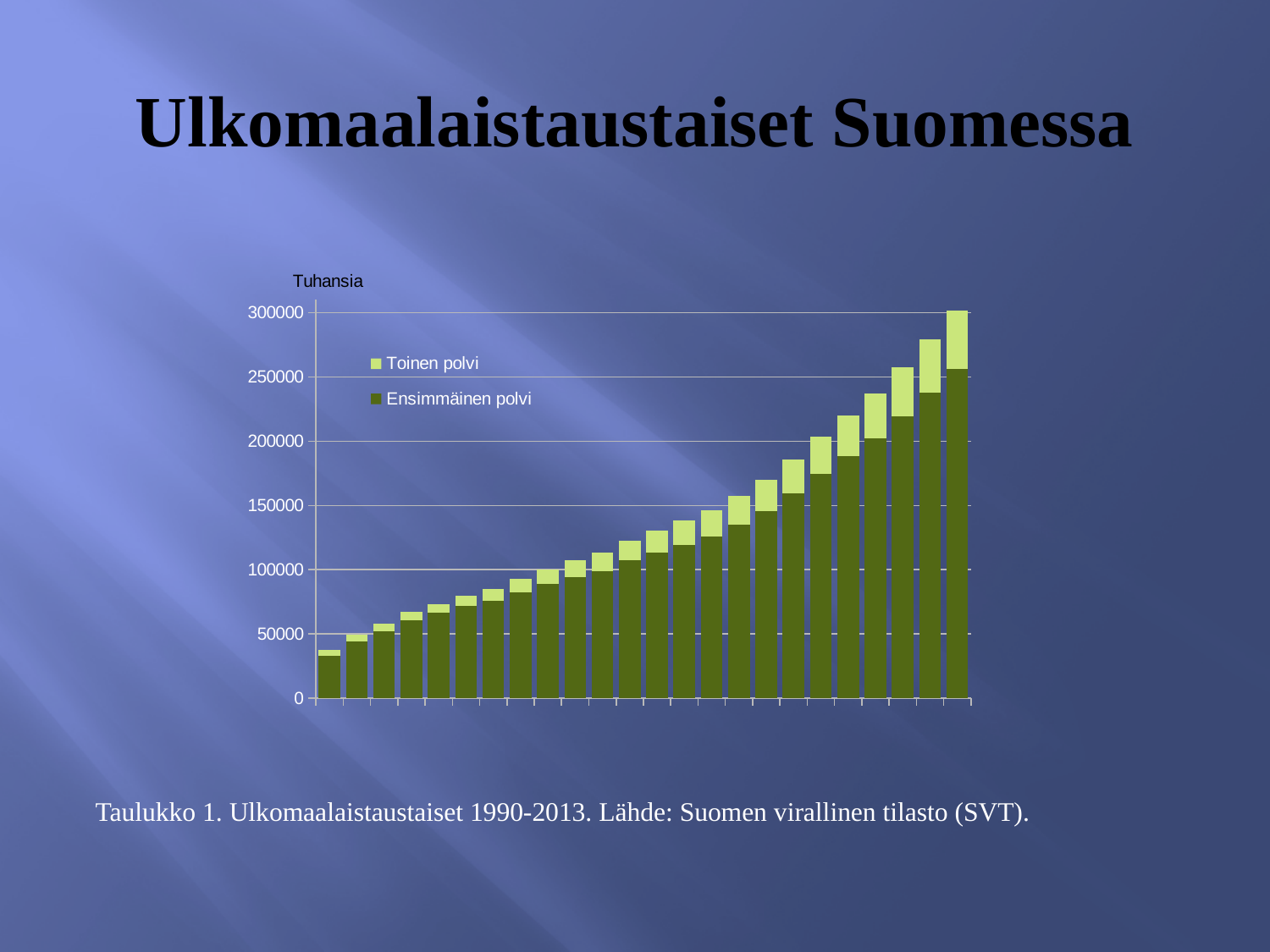
Which bar has the highest total, the leftmost or the rightmost? The rightmost How many bars are plotted in the chart? 24 Is the total of the rightmost bar greater or less than 250000? greater Which bar has the lowest total, the leftmost or the rightmost? The leftmost What kind of chart is shown on the slide? Stacked bar chart What label is shown above the vertical axis of the chart? Tuhansia Do the stacked bar totals rise or fall from left to right along the x axis? Rise How many series does the chart's legend list? 2 What are the two series named in the legend? Toinen polvi and Ensimmäinen polvi Is the total of the leftmost bar greater or less than 50000? less Is the Ensimmäinen polvi value in the rightmost bar greater or less than 200000? greater In the rightmost bar, which series is larger, Ensimmäinen polvi or Toinen polvi? Ensimmäinen polvi